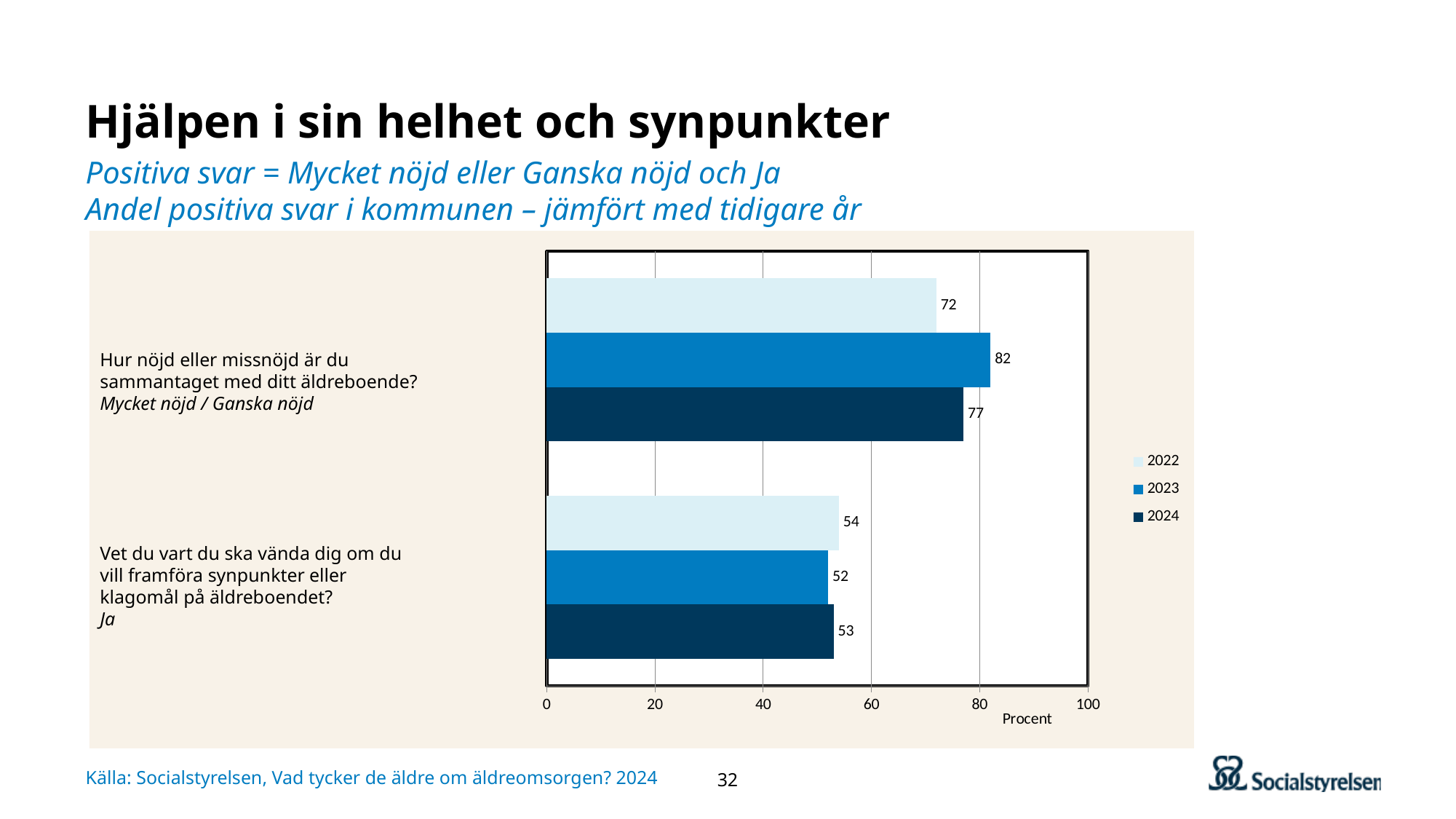
What is the 2024 value for "Hur nöjd eller missnöjd är du sammantaget med ditt äldreboende?"? 77 How many series does the legend list? 3 Which year has the lowest value for "Vet du vart du ska vända dig om du vill framföra synpunkter eller klagomål på äldreboendet?"? 2023 Which is larger: the 2024 value for "Hur nöjd eller missnöjd är du sammantaget med ditt äldreboende?" or the 2024 value for "Vet du vart du ska vända dig om du vill framföra synpunkter eller klagomål på äldreboendet?"? Hur nöjd eller missnöjd är du sammantaget med ditt äldreboende? What kind of chart is shown on the slide? bar chart Is the 2022 value for "Hur nöjd eller missnöjd är du sammantaget med ditt äldreboende?" greater or less than 60? greater How many survey questions (categories) are shown in the chart? 2 Which year has the highest value for "Hur nöjd eller missnöjd är du sammantaget med ditt äldreboende?"? 2023 What is the difference between the 2023 and 2022 values for "Hur nöjd eller missnöjd är du sammantaget med ditt äldreboende?"? 10 What is the 2023 value for "Hur nöjd eller missnöjd är du sammantaget med ditt äldreboende?"? 82 What is the 2022 value for "Vet du vart du ska vända dig om du vill framföra synpunkter eller klagomål på äldreboendet?"? 54 What is the label on the horizontal axis of the chart? Procent